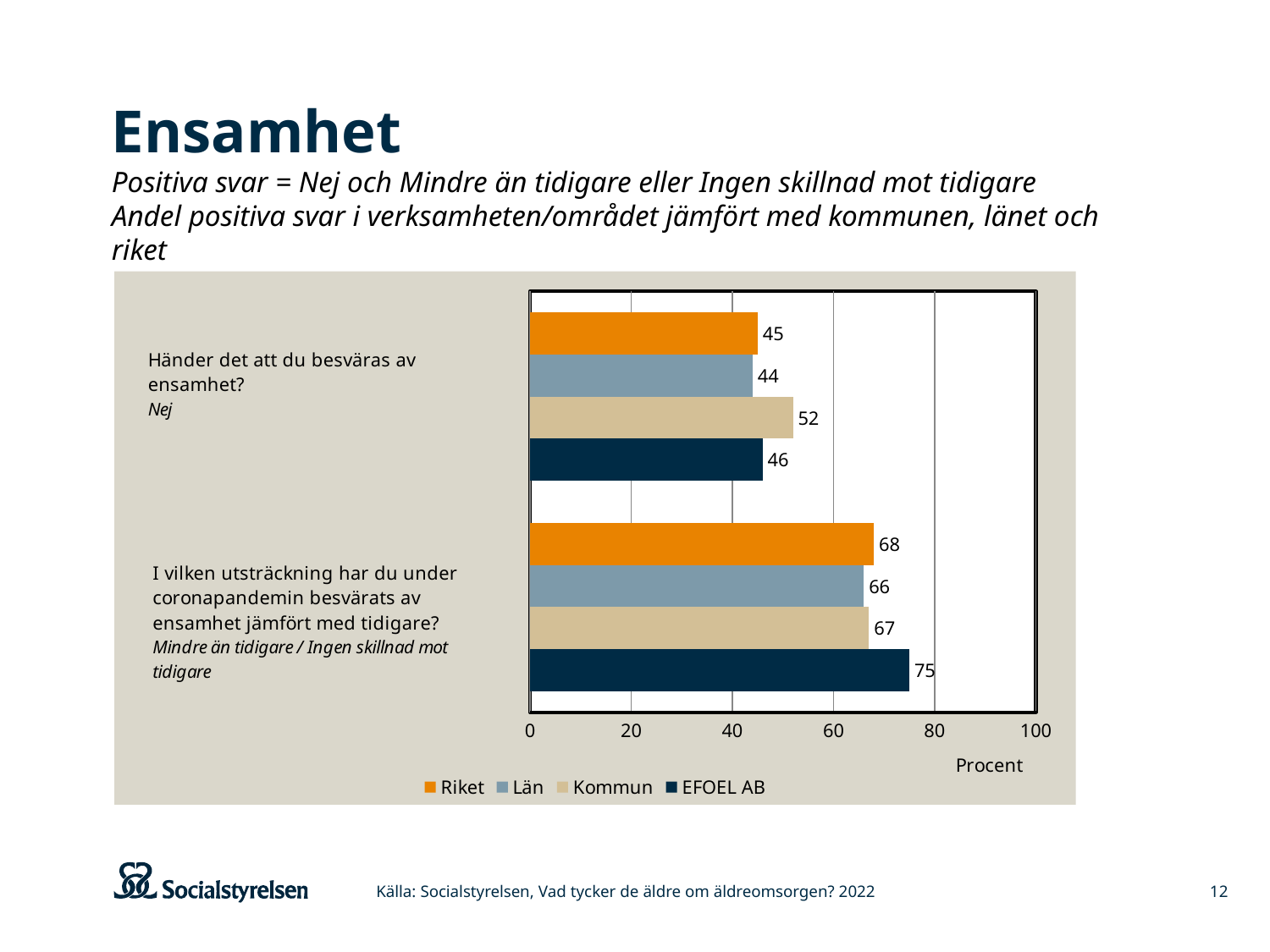
How many series does the legend list? 4 What unit is shown on the x axis of the chart? Procent What is the difference between the Kommun value and the Län value on the question 'Händer det att du besväras av ensamhet?' 8 Which series has the lowest value on the question 'Händer det att du besväras av ensamhet?' Län What is the value for Län on the question 'I vilken utsträckning har du under coronapandemin besvärats av ensamhet jämfört med tidigare?' 66 What is the value for Riket on the question 'Händer det att du besväras av ensamhet?' 45 What kind of chart is shown on the slide? Bar chart Which is larger on the question 'Händer det att du besväras av ensamhet?': the value for Kommun or the value for EFOEL AB? Kommun Which series has the highest value on the question 'I vilken utsträckning har du under coronapandemin besvärats av ensamhet jämfört med tidigare?' EFOEL AB What is the difference between the EFOEL AB value and the Riket value on the question 'I vilken utsträckning har du under coronapandemin besvärats av ensamhet jämfört med tidigare?' 7 What is the value for EFOEL AB on the question 'I vilken utsträckning har du under coronapandemin besvärats av ensamhet jämfört med tidigare?' 75 What is the value for Kommun on the question 'Händer det att du besväras av ensamhet?' 52